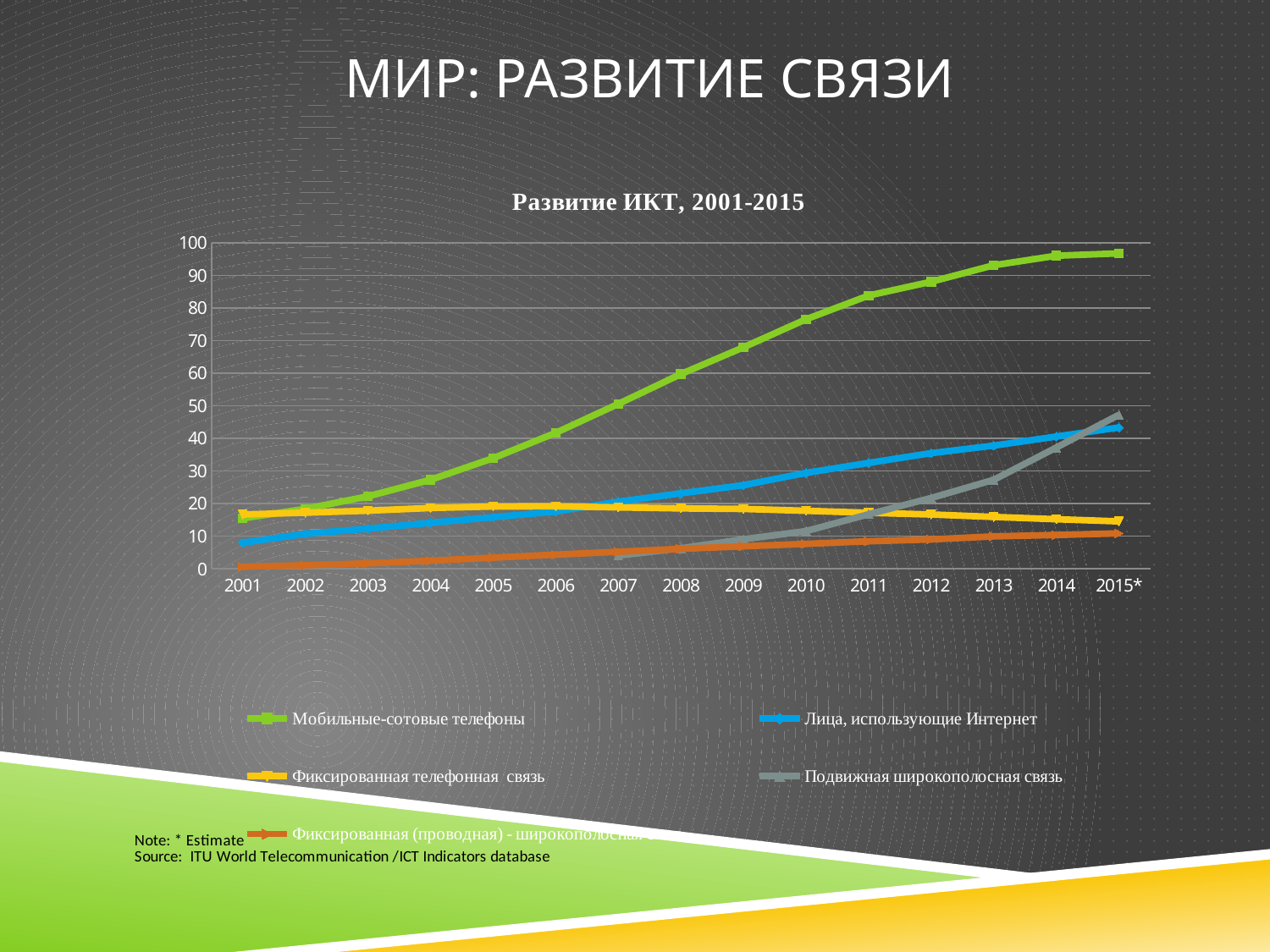
What is the title of the chart? Развитие ИКТ, 2001-2015 Is the value for Фиксированная телефонная связь in 2015* greater or less than 20? less Is the value for Лица, использующие Интернет in 2015* greater or less than 40? greater What kind of chart is shown on the slide? line chart Which series has the lowest value in 2001? Фиксированная (проводная) - широкополосная связь Is the value for Мобильные-сотовые телефоны in 2001 greater or less than 20? less How many series does the legend of the chart list? 5 Does the line for Мобильные-сотовые телефоны rise or fall from 2001 to 2015*? rise How many years are plotted along the x axis of the chart? 15 In 2013, which is larger: Лица, использующие Интернет or Подвижная широкополосная связь? Лица, использующие Интернет Which series has the highest value in 2015*? Мобильные-сотовые телефоны